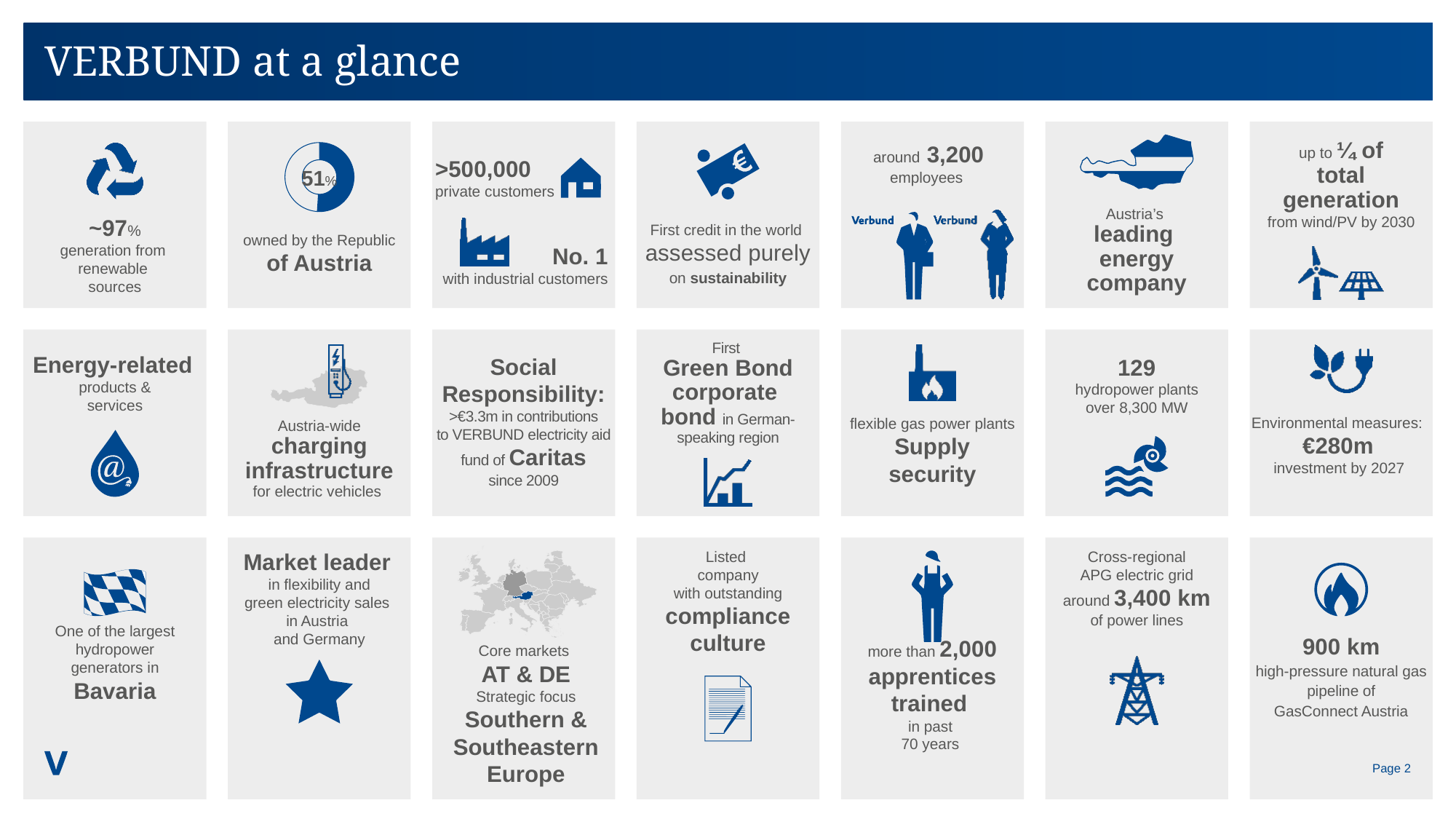
How many charts are on the slide? 1 Is the share shown in the donut chart greater or less than 50%? greater What does the 51% in the donut chart represent? owned by the Republic of Austria According to the donut chart, what share of VERBUND is owned by the Republic of Austria? 51% What percentage is shown in the donut chart in the second tile of the top row? 51% What kind of chart is shown in the tile labelled 'owned by the Republic of Austria'? donut (pie) chart